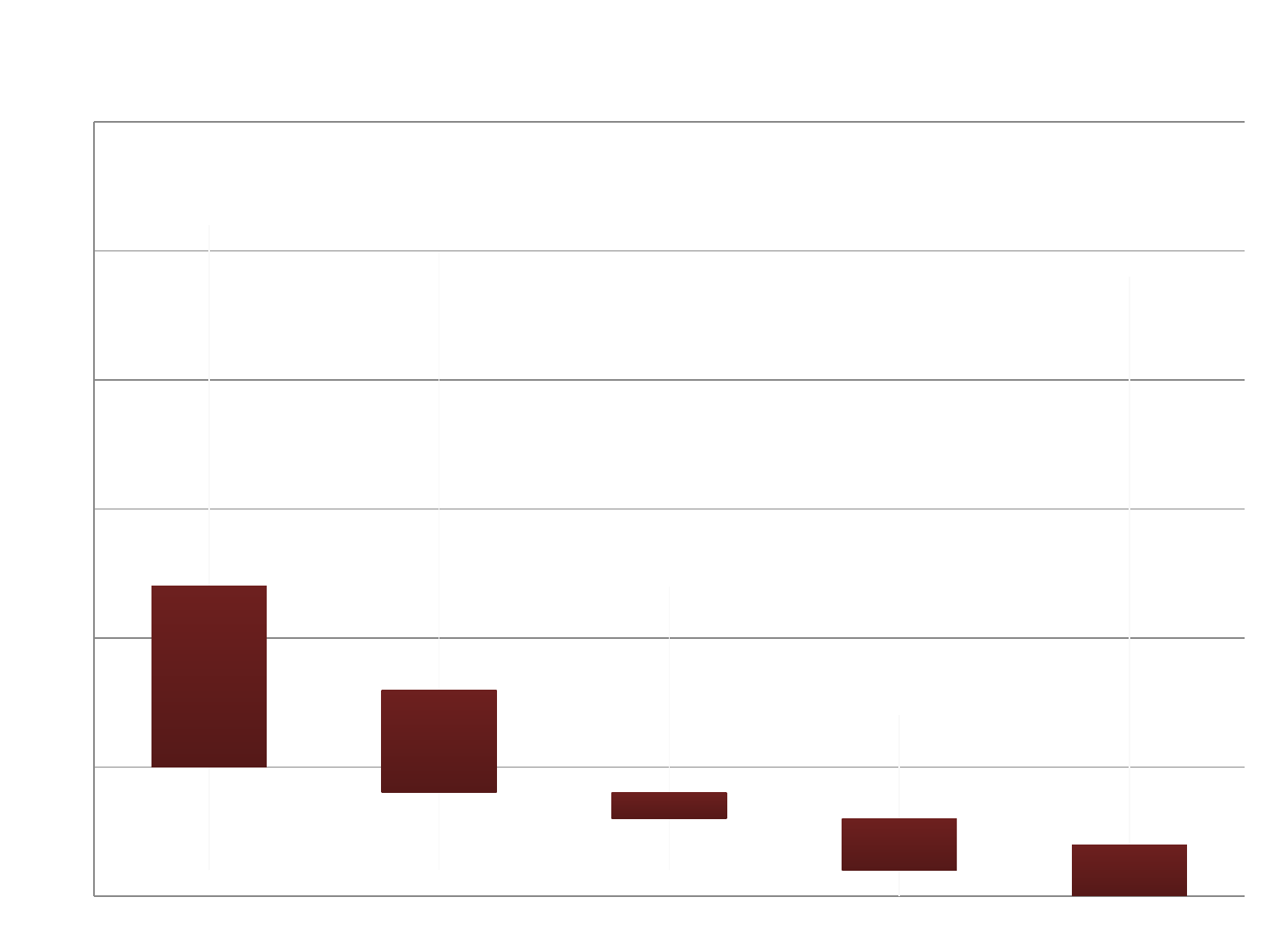
How many bars are plotted in the chart? 5 What colour are the bars in the chart? dark red Does the chart display a legend? No Do the bars rise or fall from left to right across the chart? fall What kind of chart is shown on the slide? bar chart Which bar reaches the highest point on the chart, by position? the leftmost bar Which bar in the chart is the tallest, the leftmost or the rightmost? the leftmost